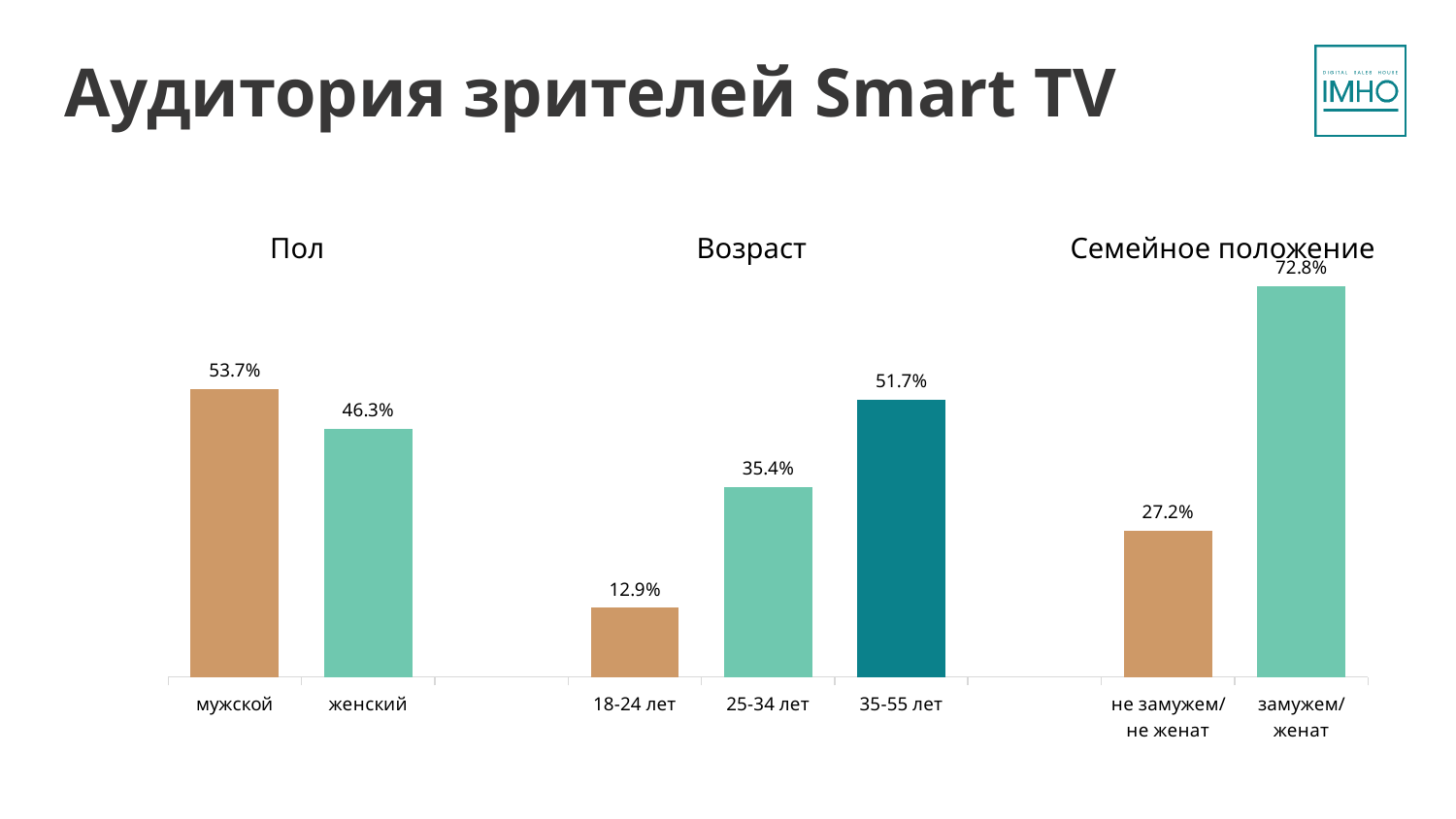
In the "Пол" chart, what is the value for женский? 46.3% How many categories are shown in the "Возраст" chart? 3 In the "Возраст" chart, which age group has the lowest value? 18-24 лет In the "Пол" chart, what is the difference between мужской and женский? 7.4% In the "Семейное положение" chart, what is the value for замужем/женат? 72.8% In the "Возраст" chart, which age group has the highest value? 35-55 лет In the "Возраст" chart, what is the value for 25-34 лет? 35.4% In the "Пол" chart, what is the value for мужской? 53.7% What kind of chart is used on this slide? Bar chart In the "Возраст" chart, which is larger: 25-34 лет or 35-55 лет? 35-55 лет In the "Семейное положение" chart, what is the difference between замужем/женат and не замужем/не женат? 45.6% In the "Возраст" chart, what is the value for 18-24 лет? 12.9%